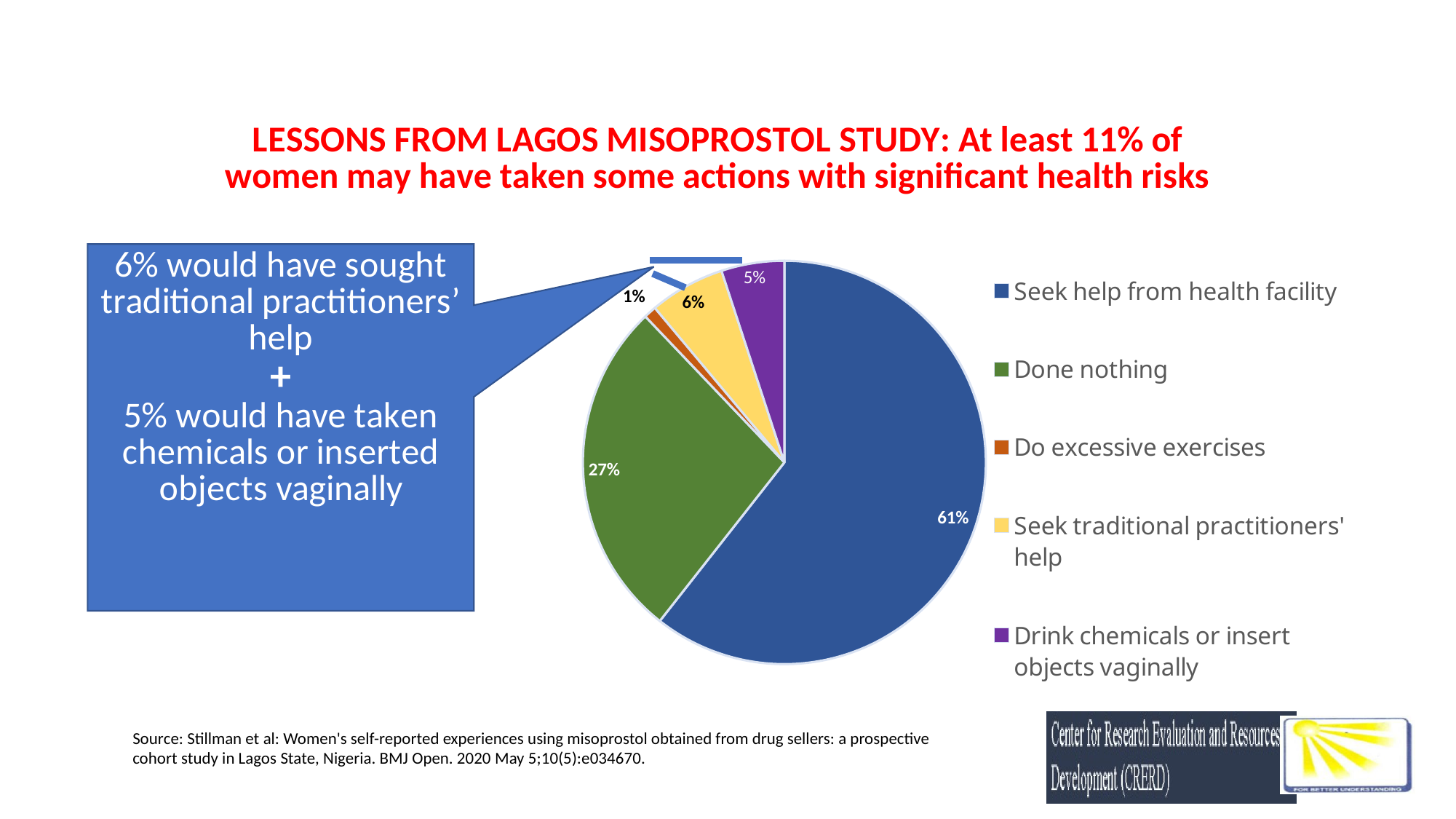
Which is larger: the share for 'Seek traditional practitioners' help' or the share for 'Drink chemicals or insert objects vaginally'? Seek traditional practitioners' help What percentage of women would do excessive exercises? 1% Which category has the smallest share of the pie? Do excessive exercises Which category has the largest share of the pie? Seek help from health facility What is the difference in percentage points between 'Seek help from health facility' and 'Done nothing'? 34 What kind of chart is shown on the slide? Pie chart What percentage of women would seek traditional practitioners' help? 6% What percentage of women would drink chemicals or insert objects vaginally? 5% What percentage of women would have done nothing? 27% What colour is the 'Done nothing' slice? Green What percentage of women would seek help from a health facility? 61% How many categories does the legend list? 5